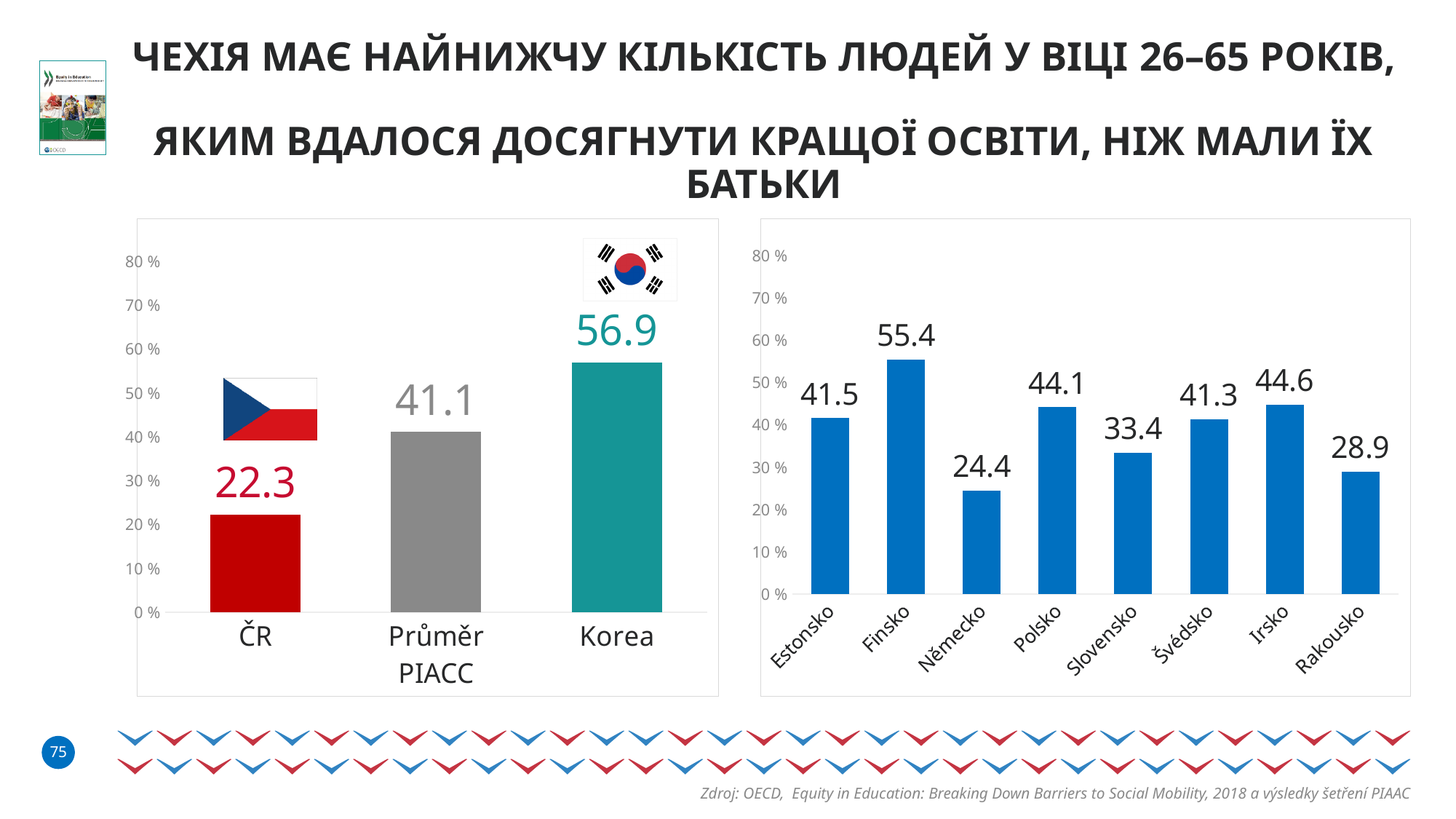
In the left chart, what is the value for Korea? 56.9 In the right chart, what is the value for Německo? 24.4 In the left chart, which category has the highest value? Korea In the right chart, which is larger, the value for Polsko or the value for Slovensko? Polsko How many countries are shown in the right chart? 8 In the left chart, what is the value for Průměr PIACC? 41.1 In the left chart, what is the difference between the values for Korea and ČR? 34.6 In the right chart, which country has the highest value? Finsko In the left chart, what is the value for ČR? 22.3 In the right chart, which country has the lowest value? Německo What kind of chart is the right chart? bar chart In the right chart, what is the value for Finsko? 55.4